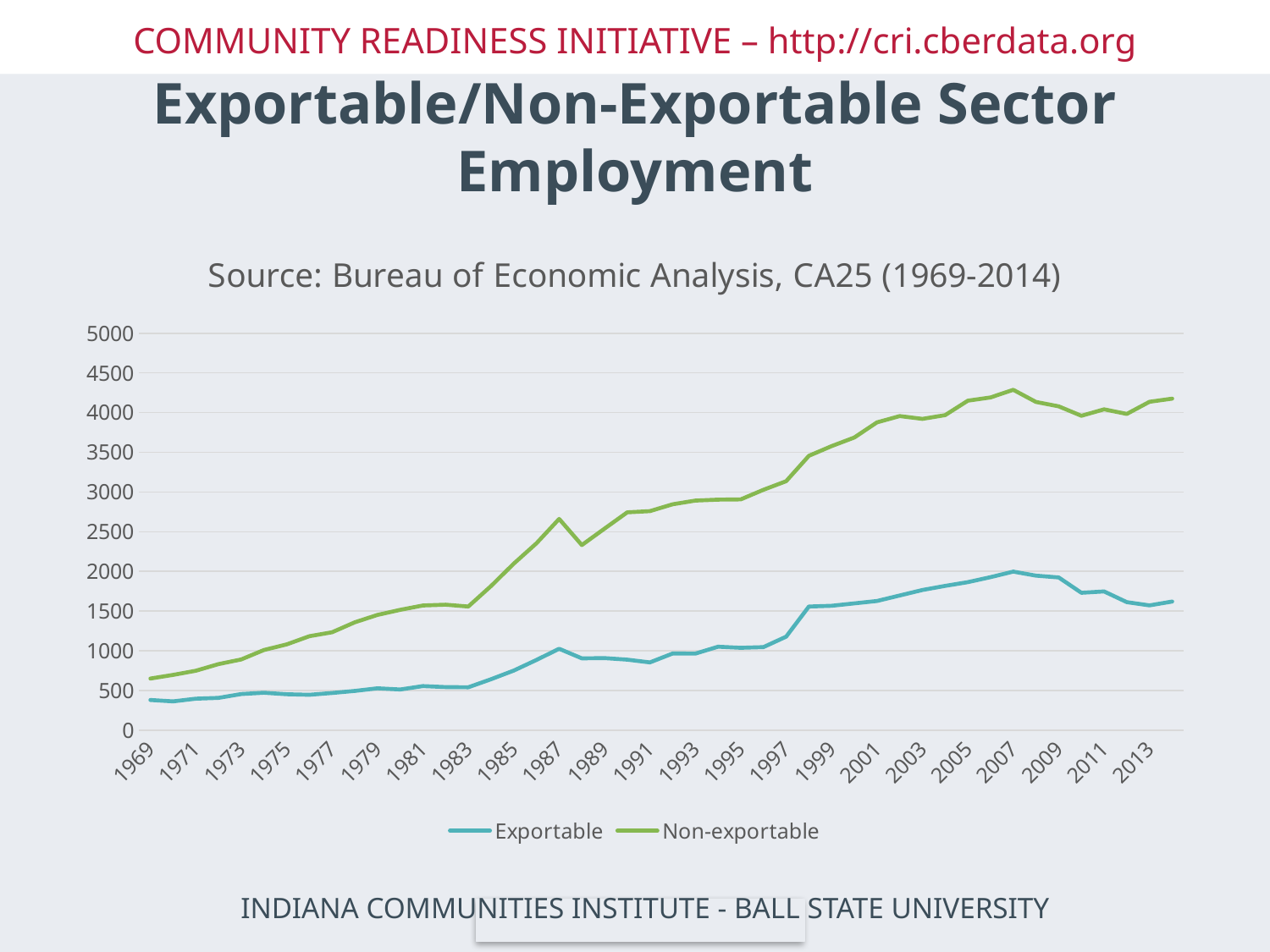
What kind of chart is shown on the slide? line chart Does the Exportable series rise or fall from 2007 to 2014? fall Is the Non-exportable value in 1987 greater or less than 2500? greater What are the two series named in the legend? Exportable and Non-exportable Which series has the higher value in 2001, Exportable or Non-exportable? Non-exportable Does the Non-exportable series generally rise or fall from 1969 to 2014? rise Is the Non-exportable value in 2007 greater or less than 4000? greater What source is cited in the chart subtitle? Bureau of Economic Analysis, CA25 (1969-2014) Is the Exportable value in 1969 greater or less than 500? less How many series does the legend list? 2 In which year does the Non-exportable series reach its highest value? 2007